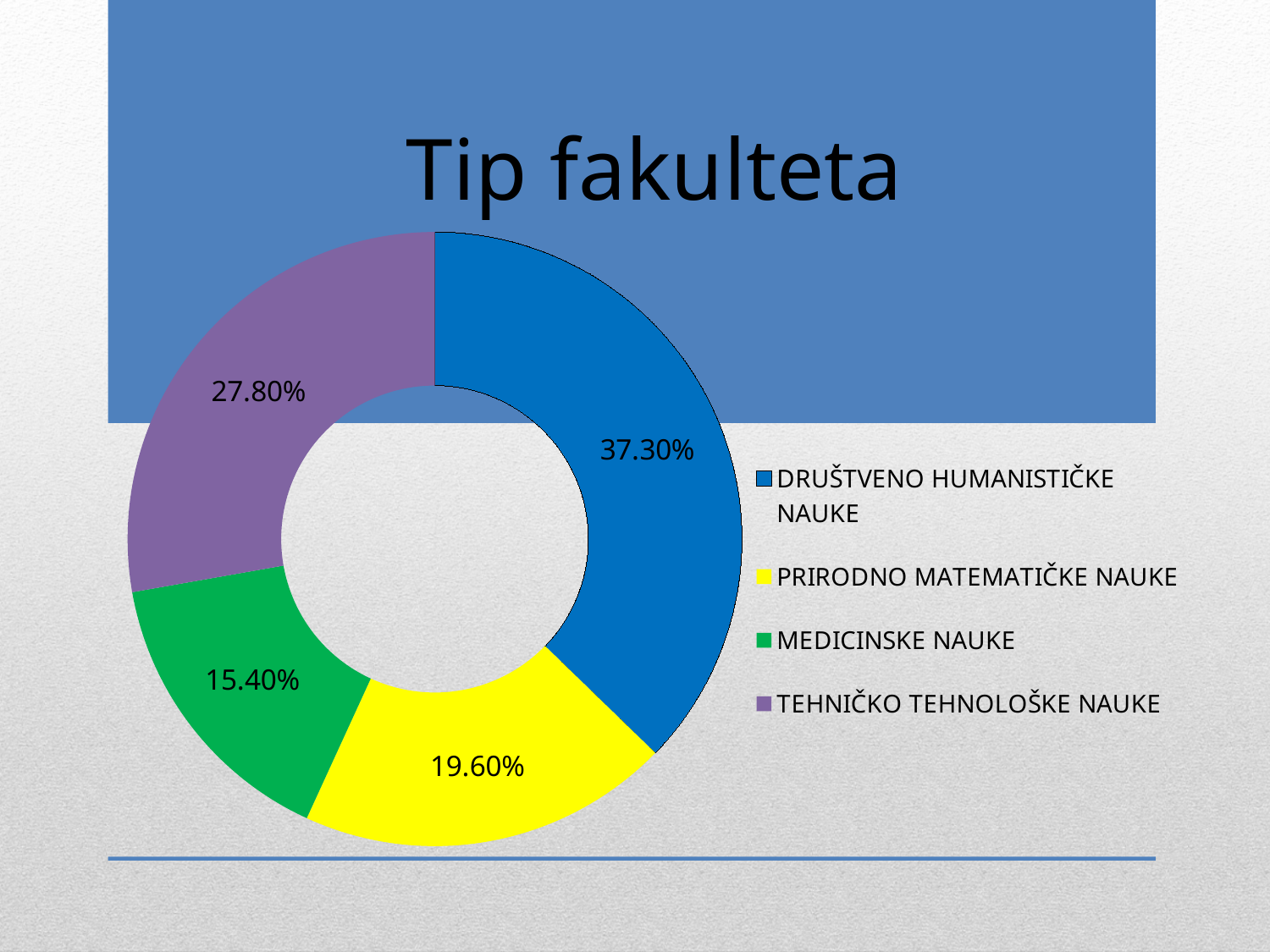
What is the value for MEDICINSKE NAUKE? 15.40% What is the value for TEHNIČKO TEHNOLOŠKE NAUKE? 27.80% How many categories does the chart show? 4 What is the value for DRUŠTVENO HUMANISTIČKE NAUKE? 37.30% Which colour represents MEDICINSKE NAUKE in the chart? Green What is the title of the chart? Tip fakulteta Which category has the smallest share? MEDICINSKE NAUKE Which is larger, the value for PRIRODNO MATEMATIČKE NAUKE or the value for MEDICINSKE NAUKE? PRIRODNO MATEMATIČKE NAUKE What is the value for PRIRODNO MATEMATIČKE NAUKE? 19.60% Which category has the largest share? DRUŠTVENO HUMANISTIČKE NAUKE What is the difference between the values for DRUŠTVENO HUMANISTIČKE NAUKE and TEHNIČKO TEHNOLOŠKE NAUKE? 9.50% What kind of chart is shown on the slide? Doughnut chart